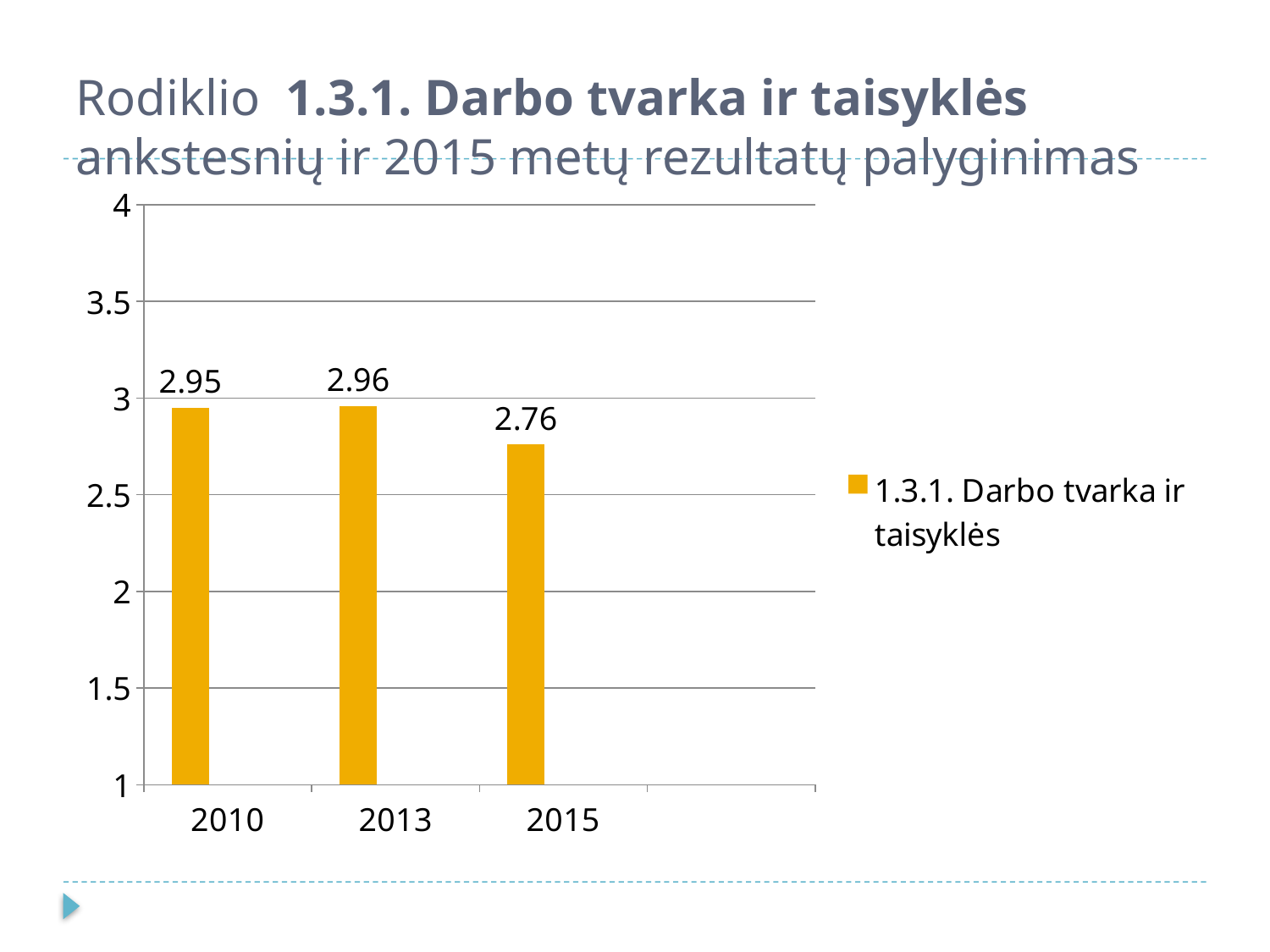
What is the value for 2015? 2.76 Is the value for 2015 greater or less than 3? less What is the legend entry for the series? 1.3.1. Darbo tvarka ir taisyklės What is the value for 2010? 2.95 How many series does the legend list? 1 Which year has the lowest value? 2015 What is the value for 2013? 2.96 How many years are shown on the x axis? 3 What kind of chart is shown on the slide? bar chart Which is larger, the value for 2010 or the value for 2015? 2010 What is the difference between the values for 2010 and 2015? 0.19 What is the difference between the values for 2013 and 2015? 0.2